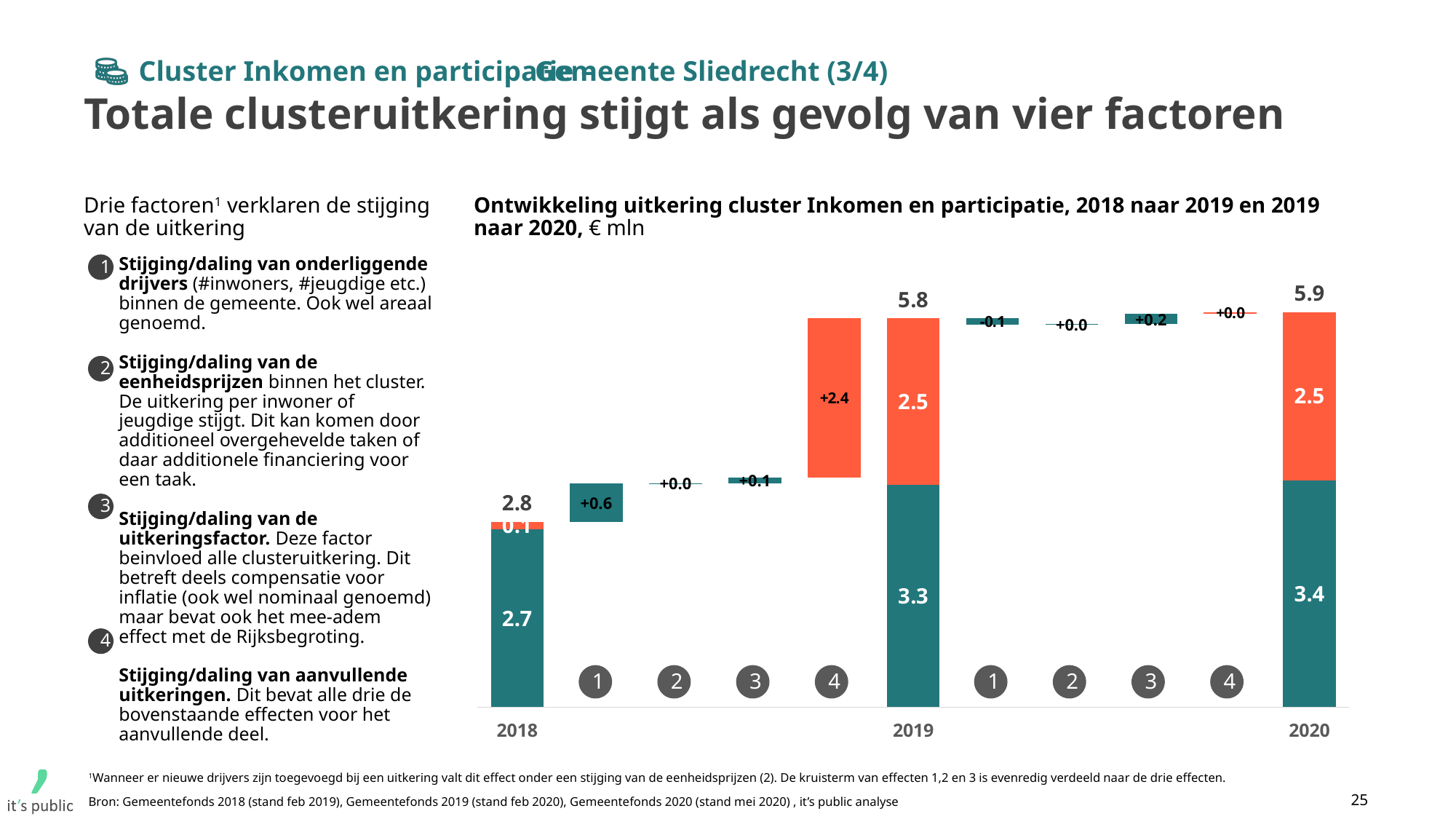
Which year has the lowest total uitkering? 2018 What is the value of the orange (upper) segment of the 2020 bar? 2.5 What is the value of the step labelled 1 between 2019 and 2020? -0.1 Which year has the highest total uitkering? 2020 What is the total uitkering shown for 2018? 2.8 By how much did the total uitkering increase from 2018 to 2019? 3.0 What is the total uitkering shown for 2019? 5.8 What is the value of the teal (lower) segment of the 2019 bar? 3.3 Which of the four steps between 2018 and 2019 has the largest value? 4 (+2.4) What is the value of the step labelled 4 between 2018 and 2019? +2.4 What is the total uitkering shown for 2020? 5.9 Does the total uitkering rise or fall from 2018 to 2020? rise